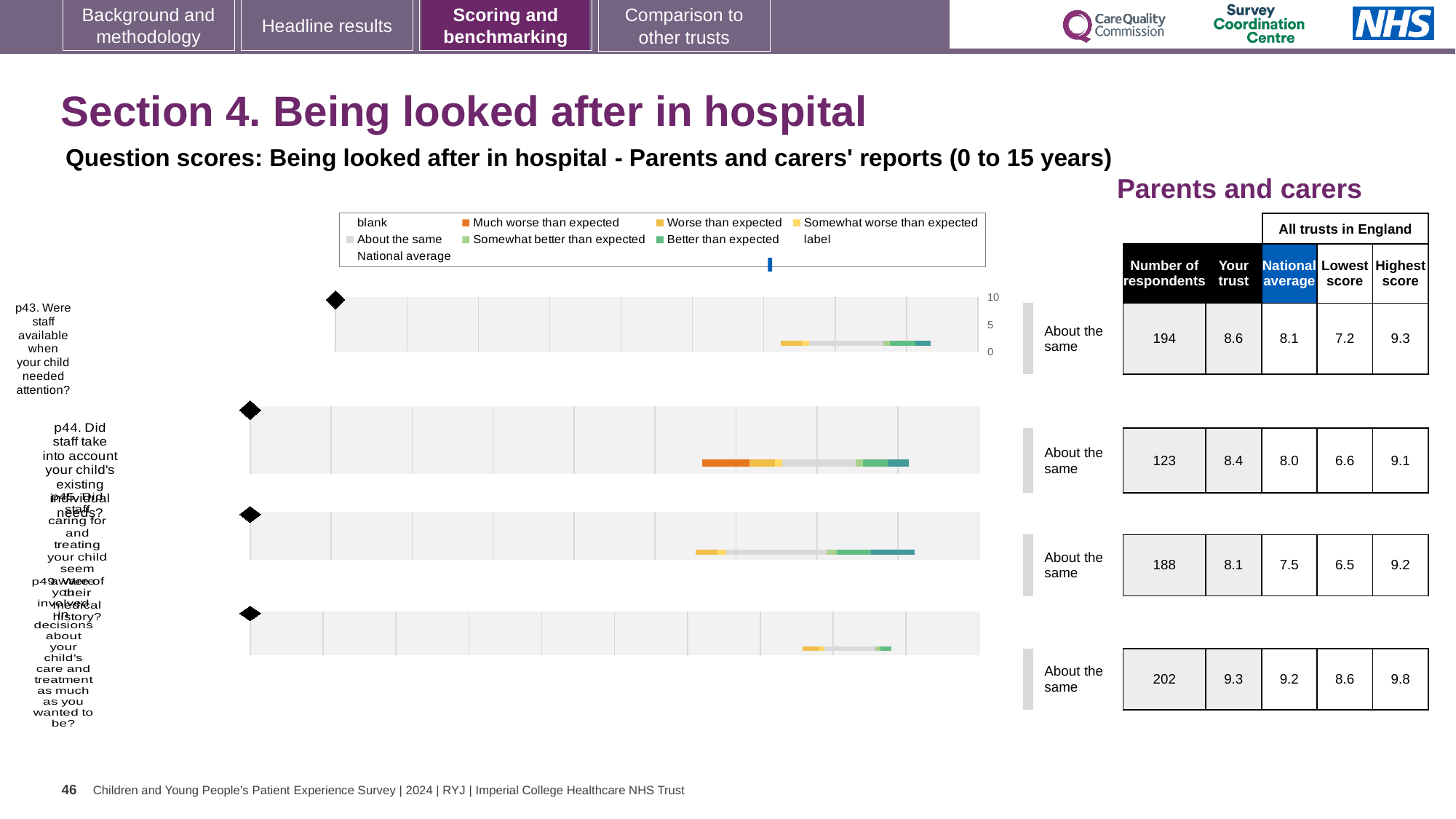
How many respondents are shown for question p43 (Were staff available when your child needed attention?)? 194 Which question row has the lowest 'Your trust' score? p45 (8.1) What benchmark category is shown for question p43? About the same Which question row has the highest 'Your trust' score? p49 (9.3) For question p43, how much higher is the 'Your trust' score than the national average? 0.5 How many question rows are plotted on the slide? 4 What is the 'Your trust' score for question p43? 8.6 For question p44, which is larger: the 'Your trust' score or the national average? Your trust (8.4) What is the national average score for question p44 (Did staff take into account your child's existing individual needs?)? 8.0 What is the lowest score among all trusts in England for question p49? 8.6 What is the highest score among all trusts in England for question p45? 9.2 For question p49, what is the difference between the highest score and the lowest score among all trusts in England? 1.2